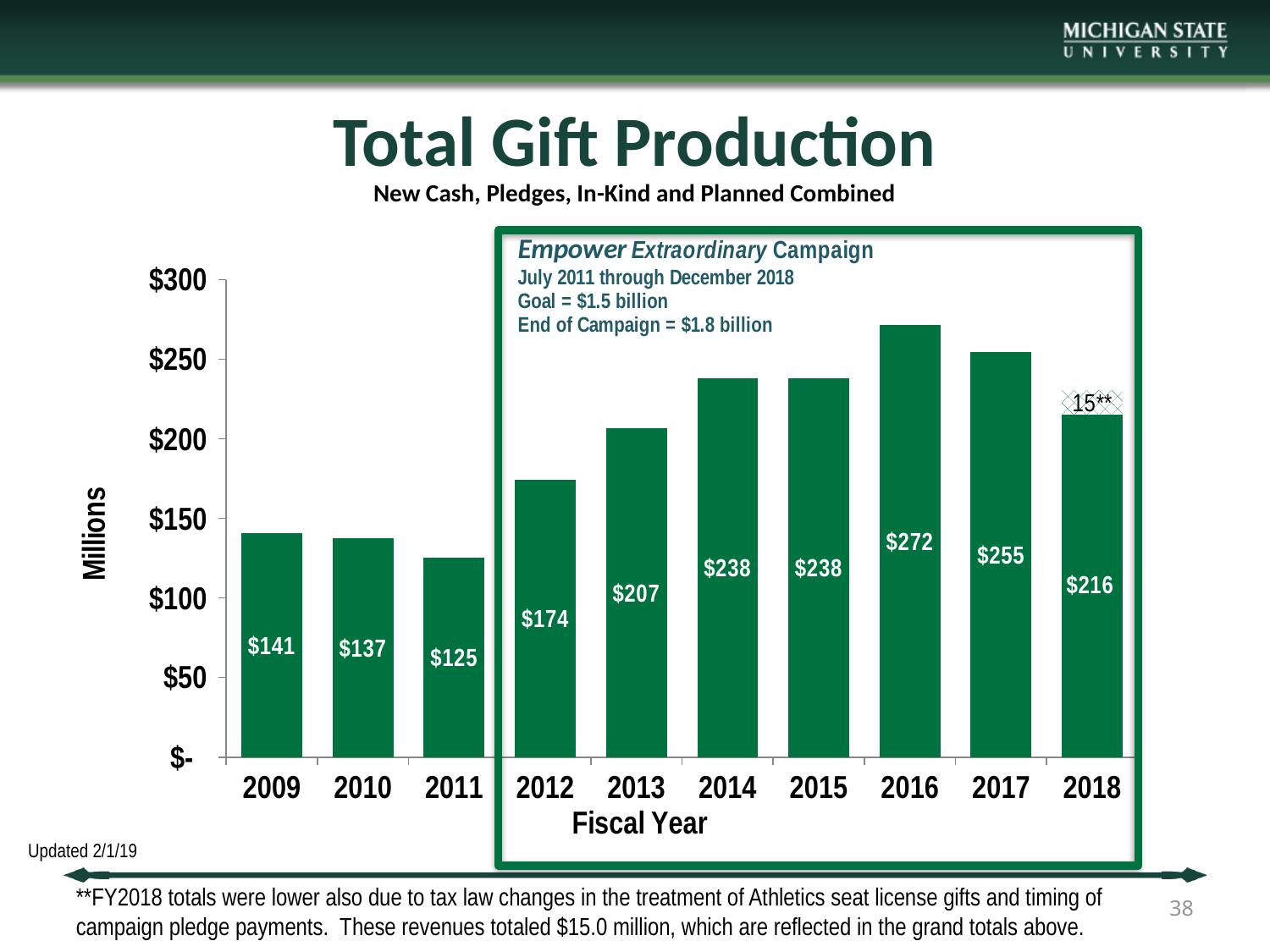
Which is larger, the value for 2013 or the value for 2018? 2018 Which fiscal year has the highest total gift production? 2016 Is the value for 2014 greater or less than $200? greater Which fiscal year has the lowest total gift production? 2011 How many fiscal years are shown on the x axis? 10 What is the value for fiscal year 2016? $272 What is the value for fiscal year 2011? $125 What is the value for fiscal year 2018? $216 What is the label on the y axis? Millions What is the difference between the values for 2012 and 2009? $33 What is the difference between the values for 2016 and 2017? $17 What kind of chart is shown on the slide? bar chart